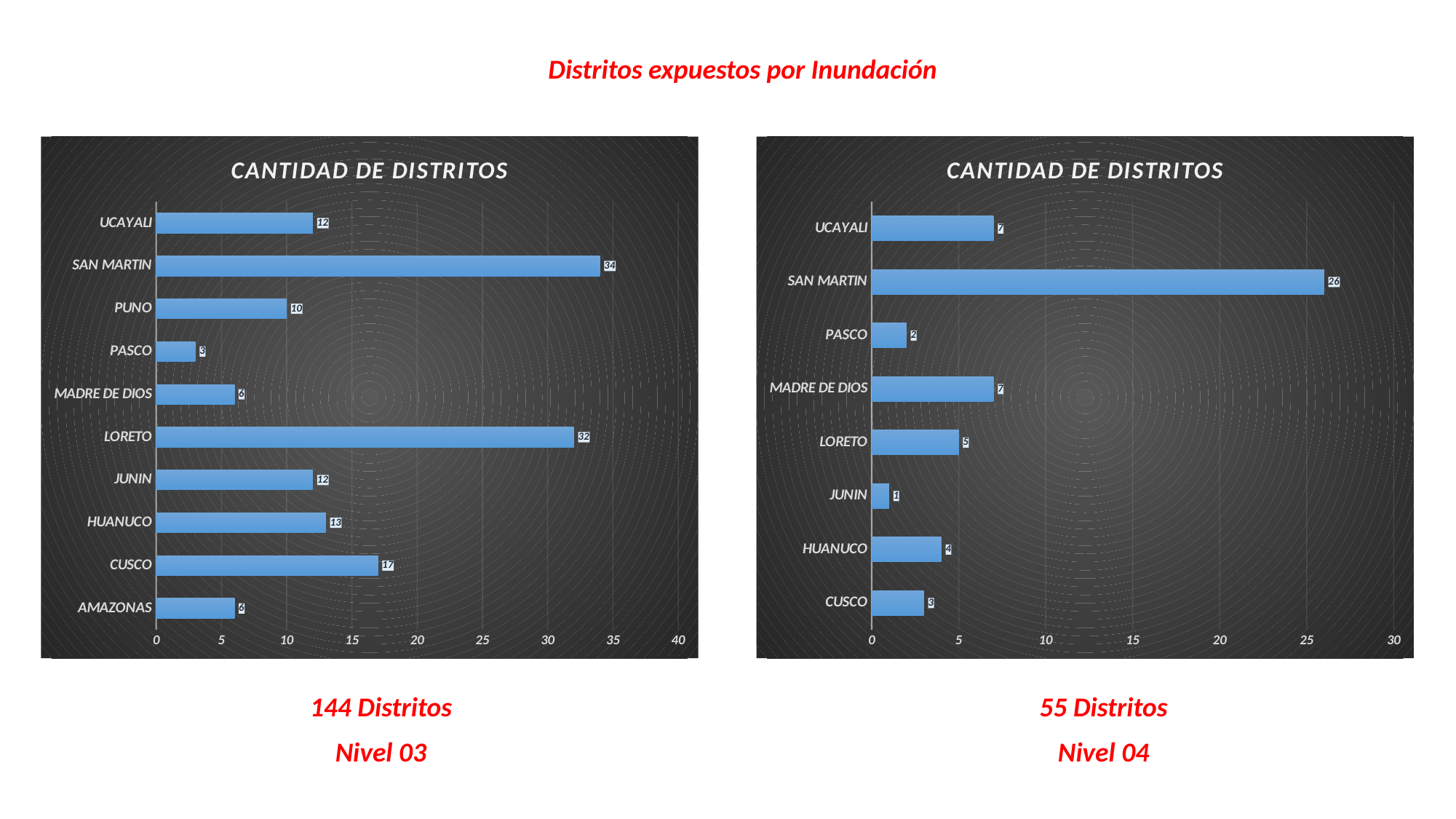
In the right chart (Nivel 04), which category has the highest value? SAN MARTIN What type of chart is the right chart (Nivel 04)? Bar chart In the left chart (Nivel 03), which is larger, the value for HUANUCO or the value for PUNO? HUANUCO How many categories are shown in the left chart (Nivel 03)? 10 In the left chart (Nivel 03), what is the value for SAN MARTIN? 34 In the left chart (Nivel 03), what is the difference between the values for SAN MARTIN and LORETO? 2 In the left chart (Nivel 03), which category has the lowest value? PASCO In the right chart (Nivel 04), which category has the lowest value? JUNIN In the right chart (Nivel 04), what is the value for MADRE DE DIOS? 7 In the right chart (Nivel 04), what is the difference between the values for SAN MARTIN and UCAYALI? 19 How many categories are shown in the right chart (Nivel 04)? 8 In the left chart (Nivel 03), what is the value for CUSCO? 17